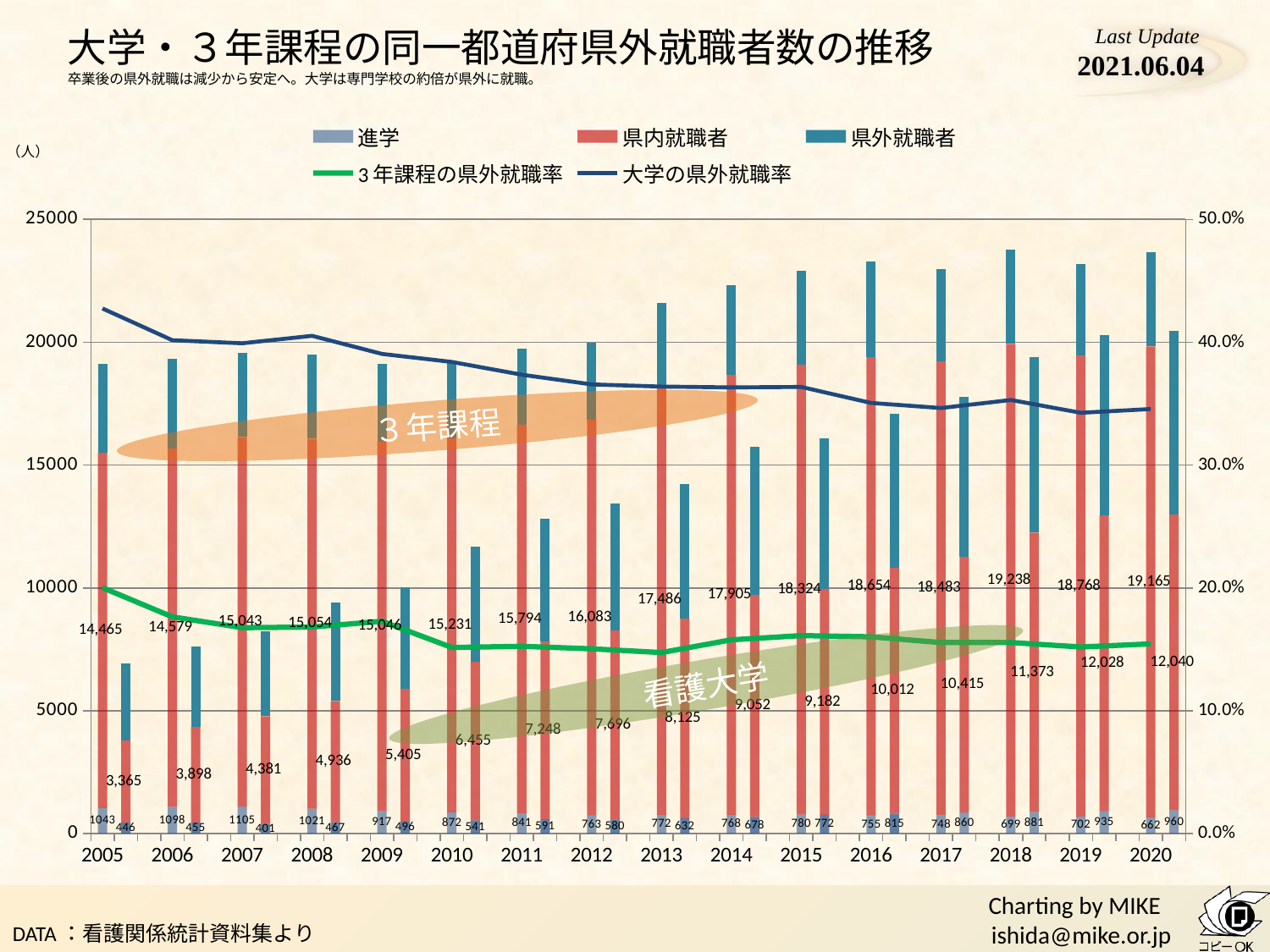
What kind of chart is this? Combined bar and line chart What is the difference between the labeled 看護大学 values for 2020 (12,040) and 2005 (3,365)? 8,675 Do the labeled 看護大学 values rise or fall from 2005 to 2020? rise What is the chart's title? 大学・３年課程の同一都道府県外就職者数の推移 Which year has the highest labeled 県内就職者 value for 看護大学? 2020 What is the labeled 県内就職者 value for the 看護大学 bar in 2020? 12,040 Is the 大学の県外就職率 line in 2005 greater or less than 40.0%? greater How many years are shown on the x axis? 16 How many series does the legend list? 5 Which is larger, the labeled ３年課程 value for 2018 or for 2019? 2018 Which year has the lowest labeled 県内就職者 value for ３年課程? 2005 What is the labeled 県内就職者 value for the ３年課程 bar in 2005? 14,465